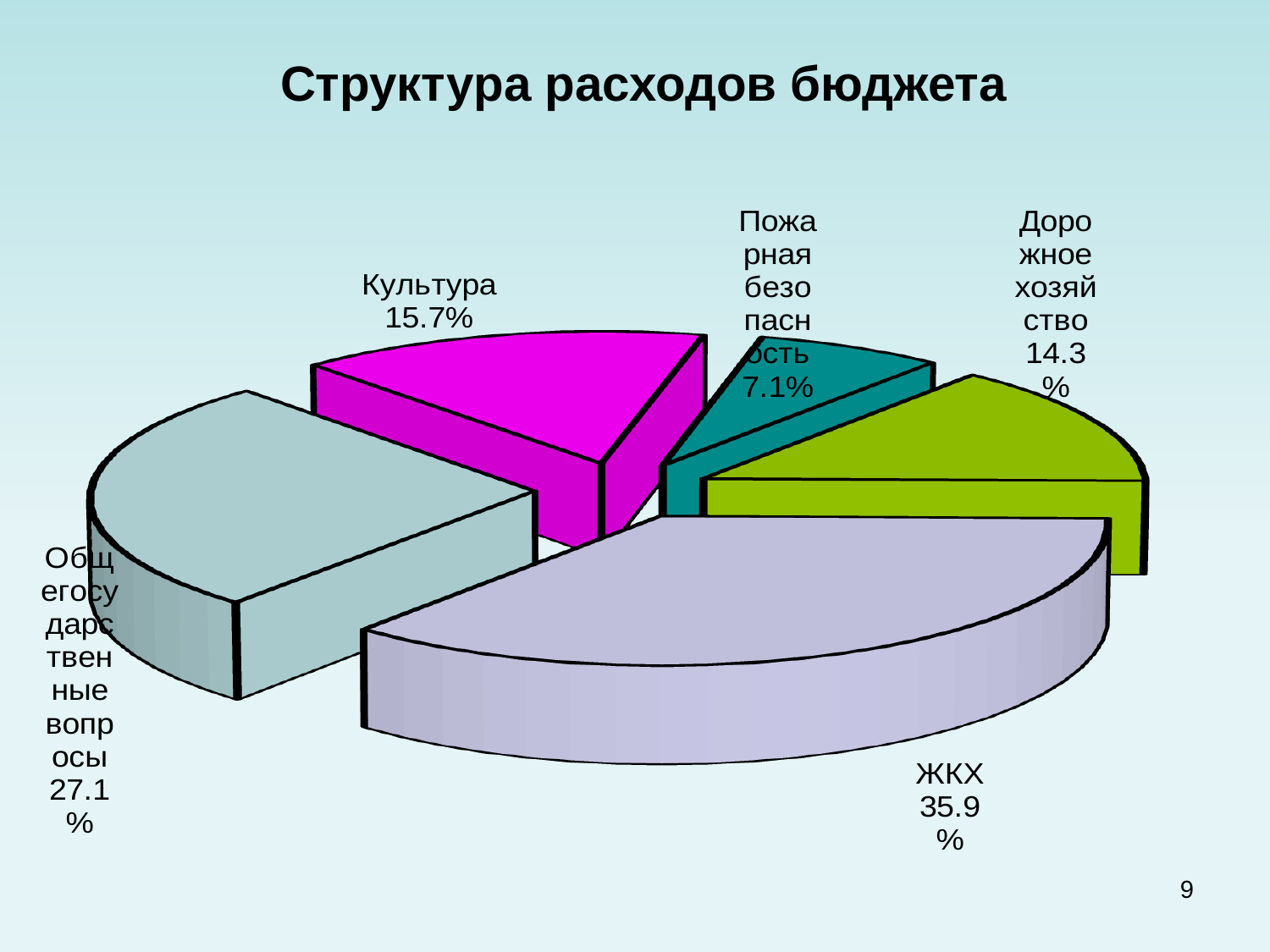
What is the title of the chart? Структура расходов бюджета How many slices does the pie chart have? 5 What share is shown for Общегосударственные вопросы? 27.1% Which category has the largest share of budget expenses? ЖКХ Which is larger, the share for Культура or the share for Дорожное хозяйство? Культура What share is shown for Дорожное хозяйство? 14.3% What share is shown for Культура? 15.7% By how many percentage points does ЖКХ exceed Общегосударственные вопросы? 8.8% Which category has the smallest share of budget expenses? Пожарная безопасность What kind of chart is shown on the slide? Pie chart What share of the budget expenses goes to ЖКХ? 35.9% What share is shown for Пожарная безопасность? 7.1%